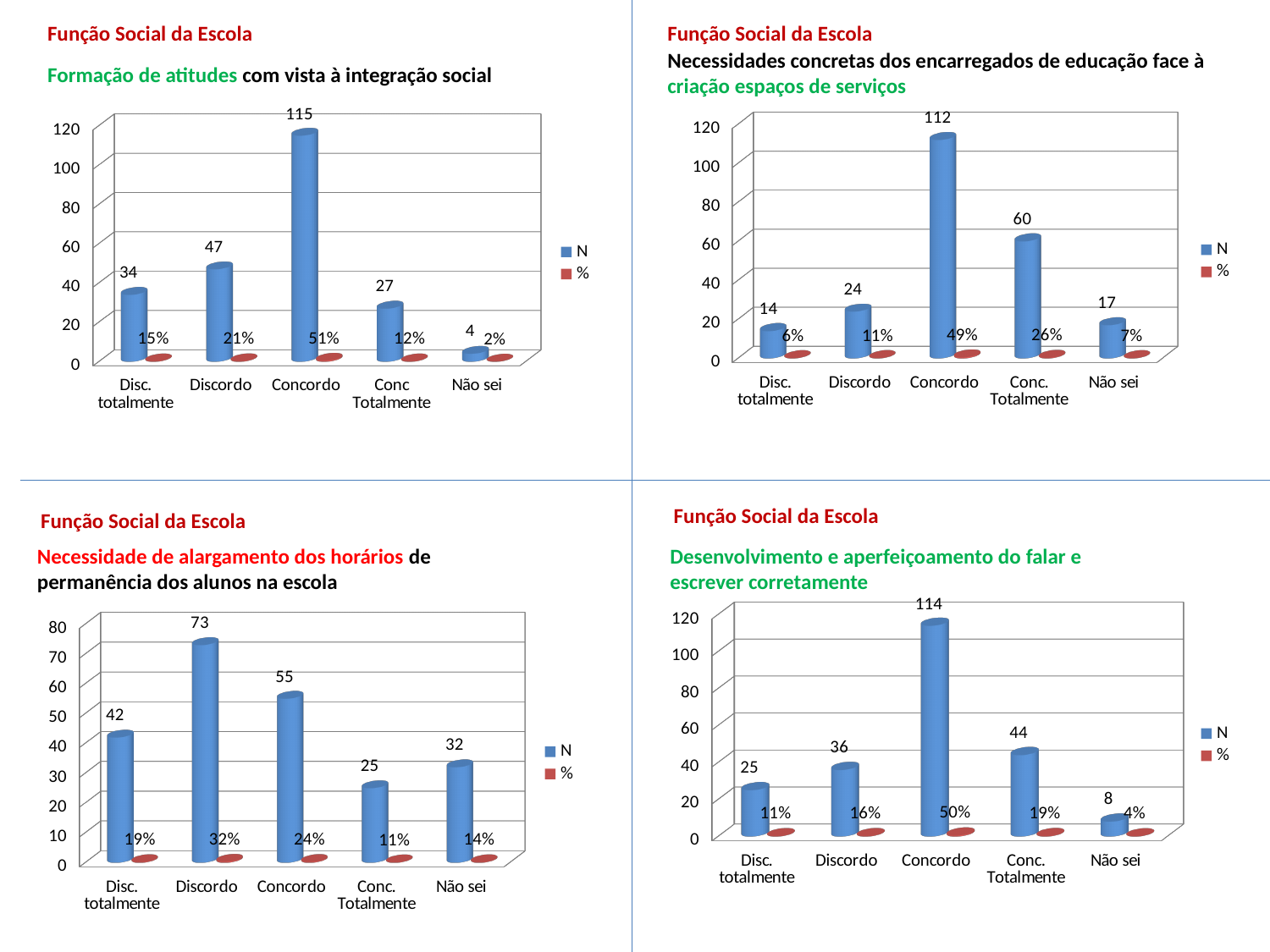
In the bottom-left chart (Necessidade de alargamento dos horários de permanência dos alunos na escola), what percentage is shown for Não sei? 14% In the bottom-left chart (Necessidade de alargamento dos horários de permanência dos alunos na escola), which is larger, the N value for Disc. totalmente or for Não sei? Disc. totalmente In the bottom-left chart (Necessidade de alargamento dos horários de permanência dos alunos na escola), which category has the highest N value? Discordo How many series does the legend list in the bottom-right chart (Desenvolvimento e aperfeiçoamento do falar e escrever corretamente)? 2 In the top-left chart (Formação de atitudes com vista à integração social), which category has the lowest N value? Não sei In the bottom-right chart (Desenvolvimento e aperfeiçoamento do falar e escrever corretamente), what is the N value for Discordo? 36 In the top-right chart (Necessidades concretas dos encarregados de educação face à criação espaços de serviços), which category has the highest N value? Concordo In the top-right chart (Necessidades concretas dos encarregados de educação face à criação espaços de serviços), what is the difference between the N values for Concordo and Conc. Totalmente? 52 In the bottom-right chart (Desenvolvimento e aperfeiçoamento do falar e escrever corretamente), how many categories are shown on the x axis? 5 In the top-left chart (Formação de atitudes com vista à integração social), what percentage is shown for Discordo? 21% In the top-left chart (Formação de atitudes com vista à integração social), what is the N value for Concordo? 115 In the top-right chart (Necessidades concretas dos encarregados de educação face à criação espaços de serviços), what is the N value for Conc. Totalmente? 60